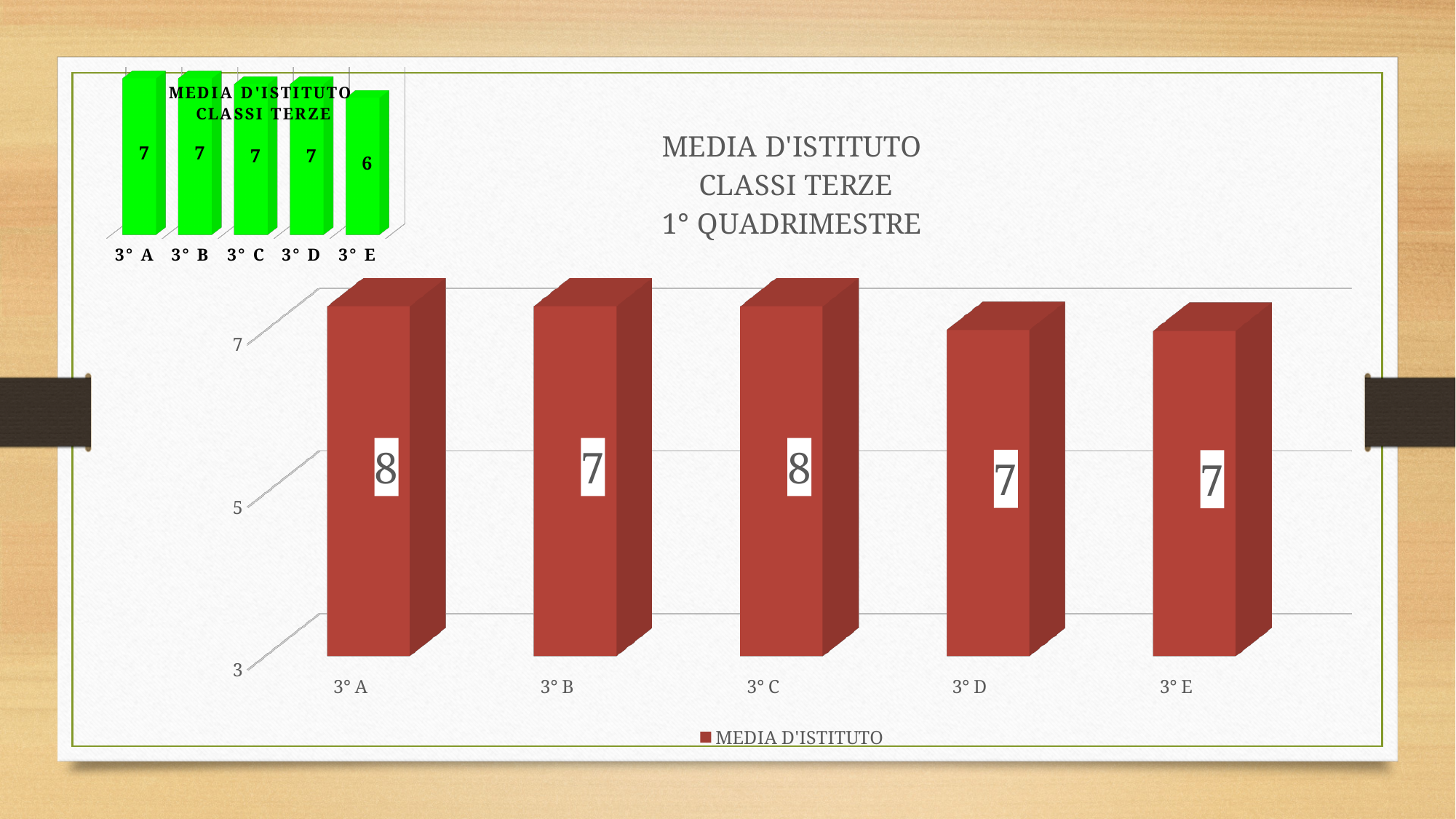
In the large chart titled 'MEDIA D'ISTITUTO CLASSI TERZE 1° QUADRIMESTRE', what is the difference between the values for 3° A and 3° B? 1 In the large chart titled 'MEDIA D'ISTITUTO CLASSI TERZE 1° QUADRIMESTRE', what is the value for 3° D? 7 In the large chart titled 'MEDIA D'ISTITUTO CLASSI TERZE 1° QUADRIMESTRE', what is the legend entry? MEDIA D'ISTITUTO In the large chart titled 'MEDIA D'ISTITUTO CLASSI TERZE 1° QUADRIMESTRE', how many classes are shown on the x axis? 5 In the small green chart at the top left, what is the value for 3° E? 6 In the large chart titled 'MEDIA D'ISTITUTO CLASSI TERZE 1° QUADRIMESTRE', what is the value for 3° A? 8 In the small green chart at the top left, which class has the lowest value? 3° E In the small green chart at the top left, what is the difference between the values for 3° A and 3° E? 1 In the small green chart at the top left, what is the value for 3° B? 7 What kind of chart is the large chart titled 'MEDIA D'ISTITUTO CLASSI TERZE 1° QUADRIMESTRE'? Bar chart In the large chart titled 'MEDIA D'ISTITUTO CLASSI TERZE 1° QUADRIMESTRE', how many series does the legend list? 1 In the large chart titled 'MEDIA D'ISTITUTO CLASSI TERZE 1° QUADRIMESTRE', what is the value for 3° C? 8